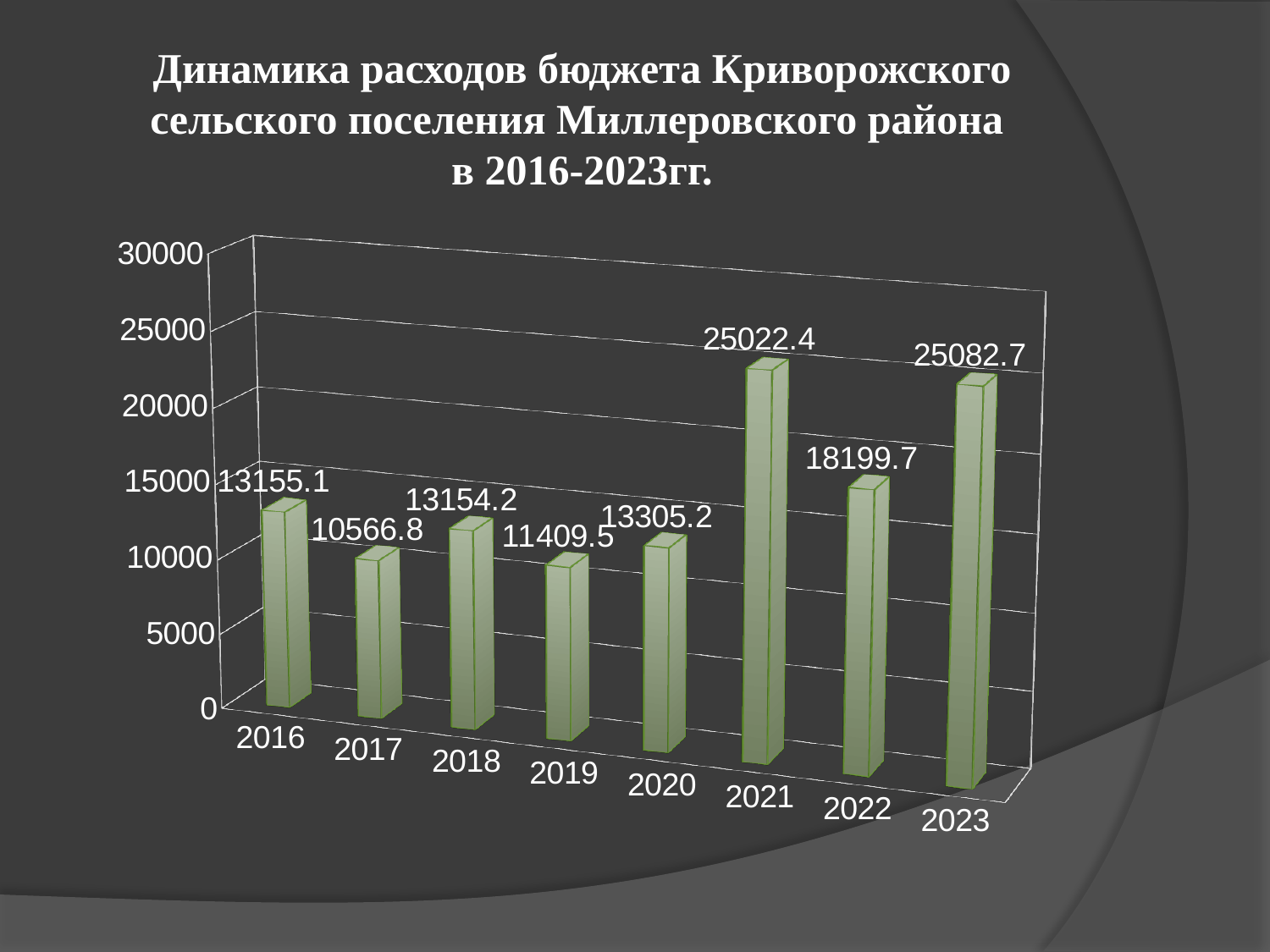
What kind of chart is this? bar chart What is the value for 2017? 10566.8 Which year has the highest value? 2023 What is the value for 2020? 13305.2 Does the value rise or fall from 2021 to 2022? fall What is the value for 2021? 25022.4 How many years are shown on the x axis? 8 Which is larger, the value for 2016 or the value for 2019? 2016 What is the difference between the values for 2022 and 2017? 7632.9 What is the difference between the values for 2023 and 2021? 60.3 Is the value for 2022 greater or less than 15000? greater Which year has the lowest value? 2017